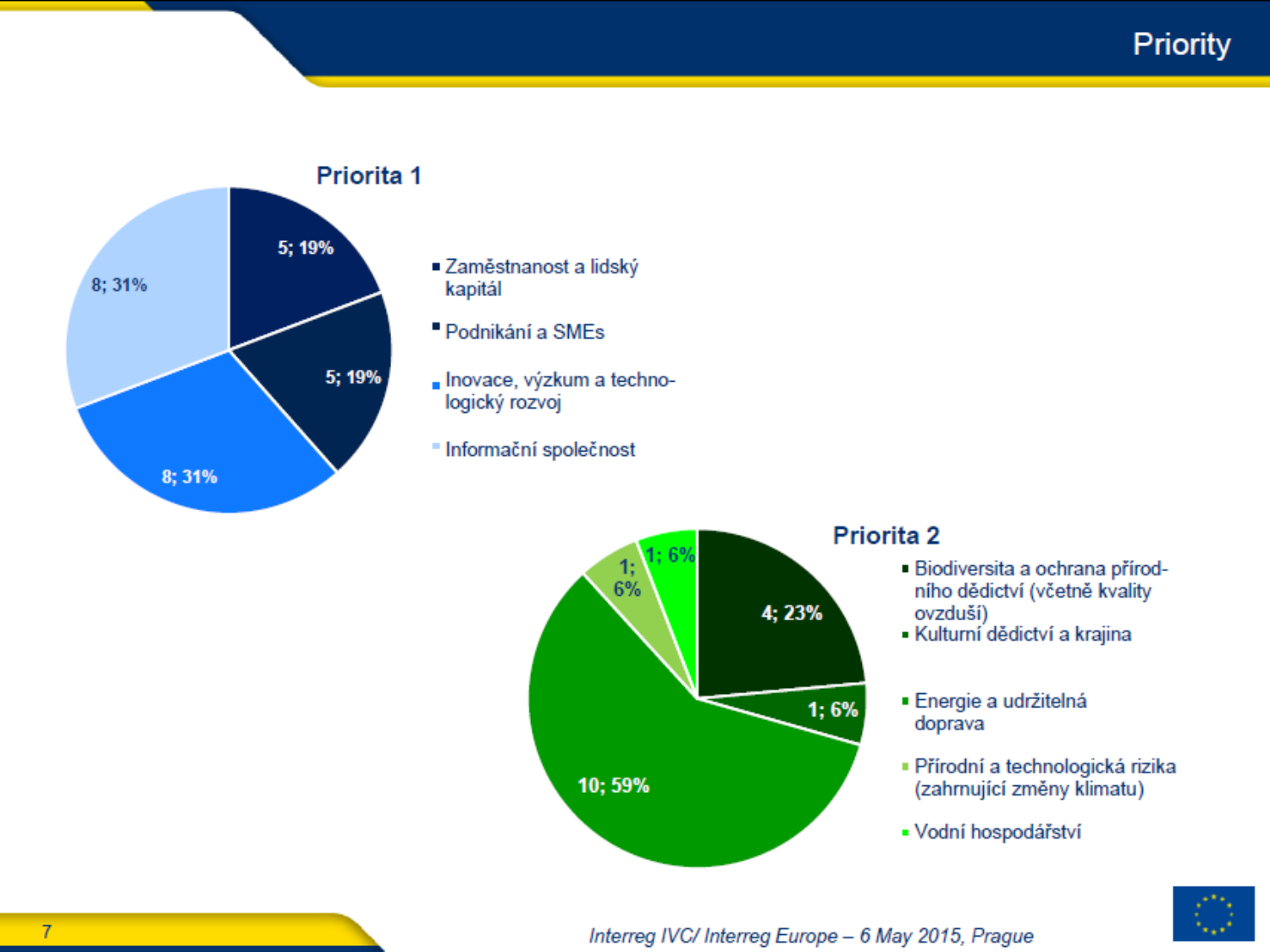
In the Priorita 1 chart, how many slices does the pie have? 4 What kind of chart is the Priorita 2 chart? Pie chart In the Priorita 2 chart, what share of the pie does Biodiversita a ochrana přírodního dědictví have? 23% In the Priorita 1 chart, what is the difference between the value for Inovace, výzkum a technologický rozvoj and the value for Podnikání a SMEs? 3 In the Priorita 1 chart, what share of the pie does Zaměstnanost a lidský kapitál have? 19% In the Priorita 2 chart, what is the difference between the value for Energie a udržitelná doprava and the value for Biodiversita a ochrana přírodního dědictví? 6 In the Priorita 2 chart, what is the value and share shown for Energie a udržitelná doprava? 10; 59% In the Priorita 1 chart, what is the value and share shown for Informační společnost? 8; 31% In the Priorita 1 chart, which is larger: Informační společnost or Zaměstnanost a lidský kapitál? Informační společnost In the Priorita 2 chart, how many categories does the legend list? 5 In the Priorita 2 chart, which category has the largest slice? Energie a udržitelná doprava In the Priorita 2 chart, what is the value shown for Vodní hospodářství? 1; 6%